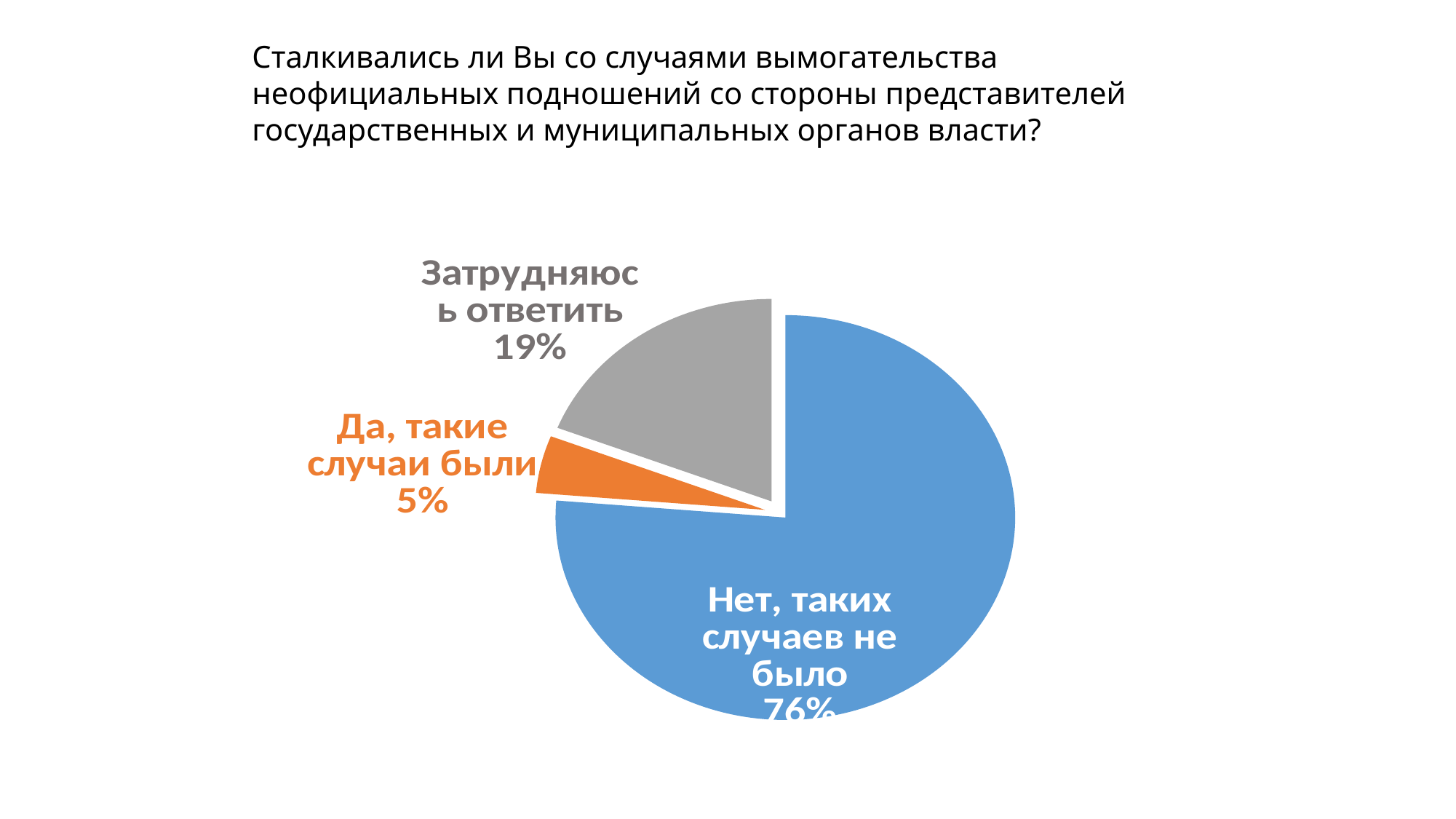
What kind of chart is shown on the slide? Pie chart What colour is the slice for "Нет, таких случаев не было"? Blue Which answer option has the smallest share of the pie? Да, такие случаи были What colour is the slice for "Да, такие случаи были"? Orange What share of respondents answered "Нет, таких случаев не было"? 76% What is the difference in percentage points between "Затрудняюсь ответить" and "Да, такие случаи были"? 14 What share of respondents answered "Затрудняюсь ответить"? 19% How many answer options (slices) does the pie chart show? 3 What is the difference in percentage points between "Нет, таких случаев не было" and "Затрудняюсь ответить"? 57 Which answer option has the largest share of the pie? Нет, таких случаев не было What share of respondents answered "Да, такие случаи были"? 5% Which is larger: the share for "Затрудняюсь ответить" or the share for "Да, такие случаи были"? Затрудняюсь ответить